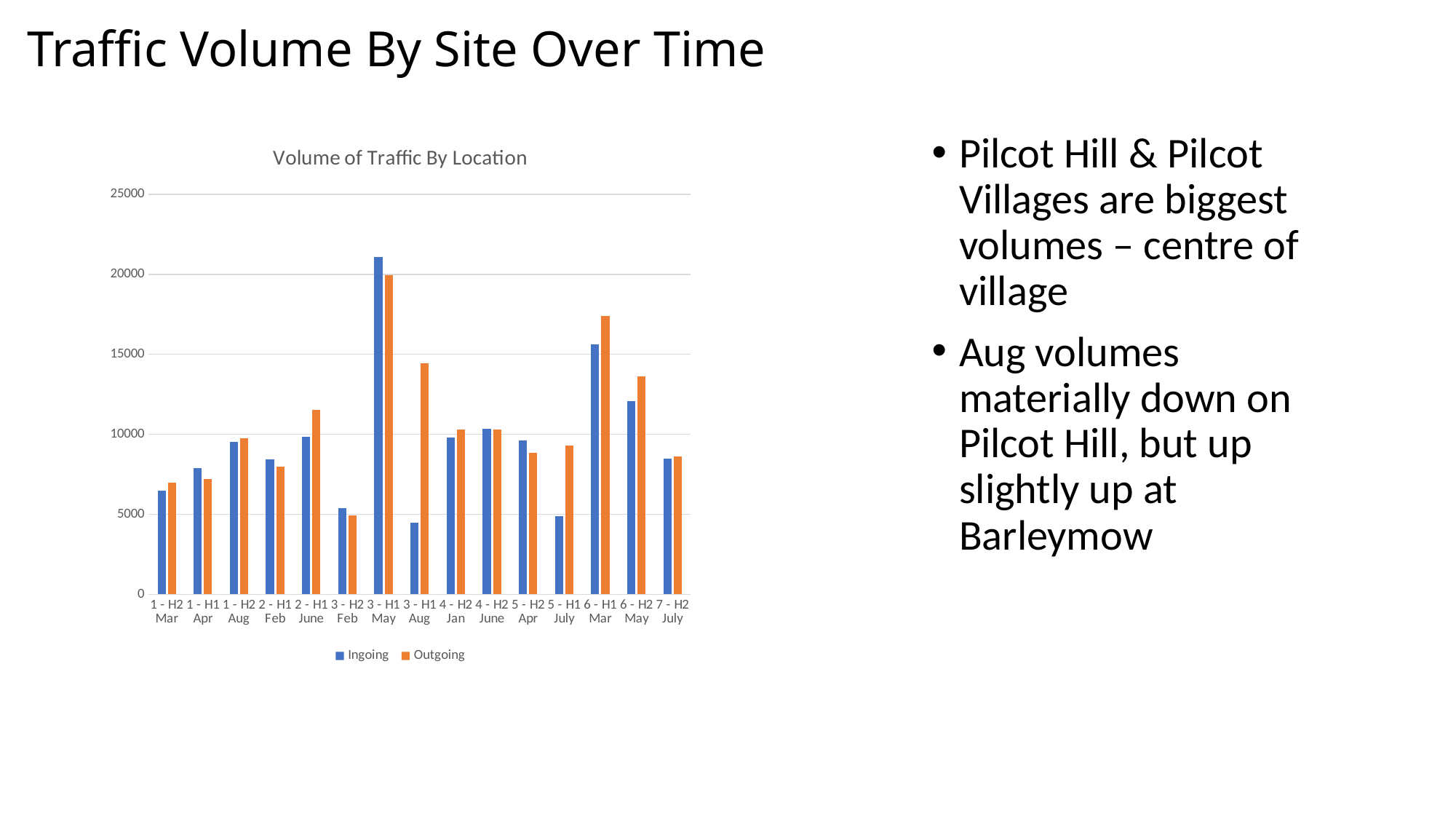
Is the Outgoing value for 3 - H1 Aug greater or less than 10000? greater Is the Ingoing value for 3 - H1 May greater or less than 20000? greater Which category has the highest Outgoing value? 3 - H1 May What kind of chart is shown on the slide? Bar chart Is the Ingoing value for 3 - H2 Feb greater or less than 10000? less How many categories are shown along the x axis of the chart? 15 For 5 - H1 July, which is larger, Ingoing or Outgoing? Outgoing Which category has the highest Ingoing value? 3 - H1 May What is the title of the chart? Volume of Traffic By Location How many series does the legend of the chart list? 2 For 3 - H1 Aug, which is larger, Ingoing or Outgoing? Outgoing Which category has the lowest Outgoing value? 3 - H2 Feb